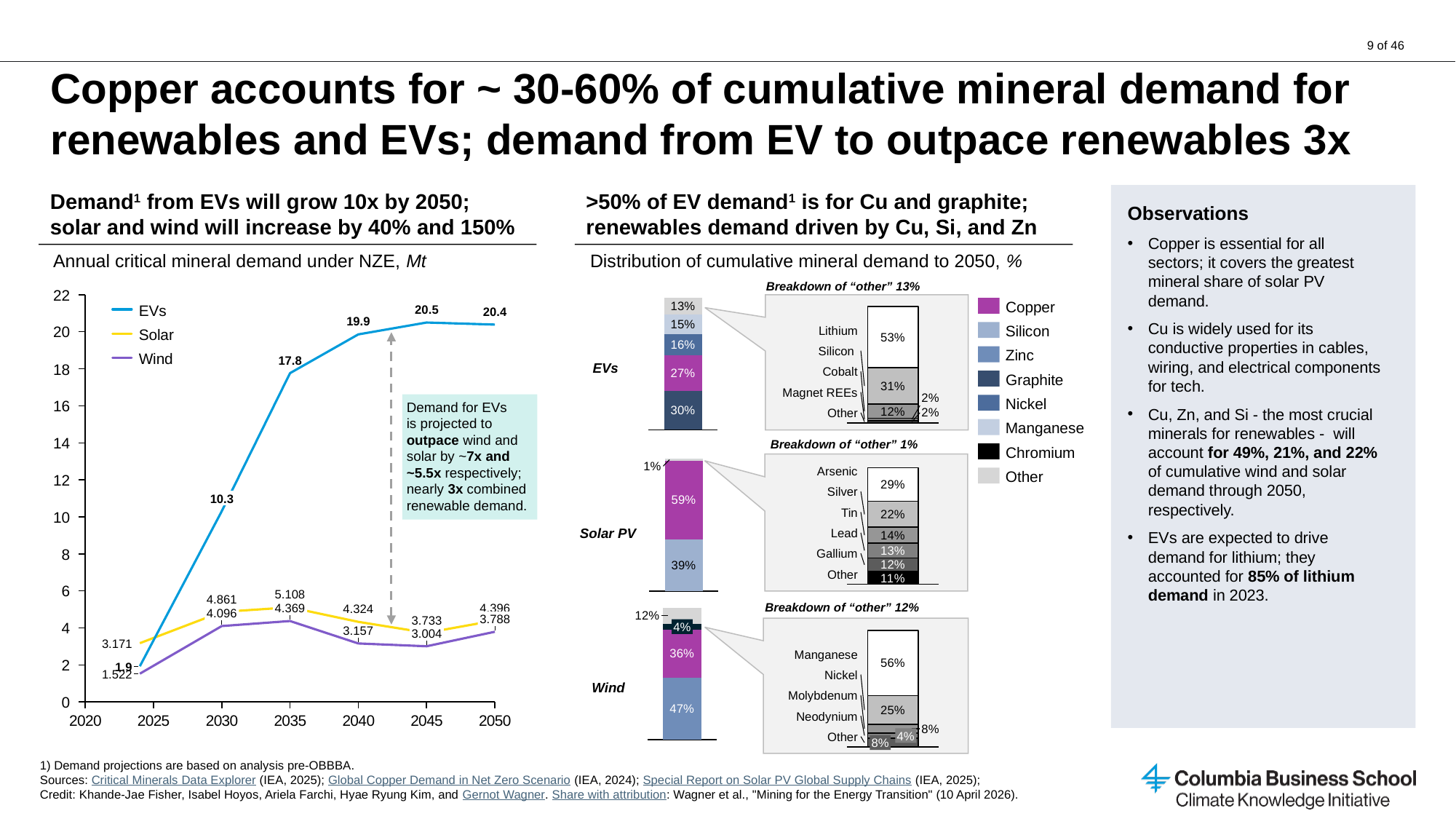
In the left chart, 'Annual critical mineral demand under NZE, Mt', which series has the highest value in 2050? EVs In the right chart, 'Distribution of cumulative mineral demand to 2050, %', what share of Solar PV demand is Copper? 59% In the right chart's 'Breakdown of "other" 13%' for EVs, what share is Lithium? 53% How many series does the legend of the left chart, 'Annual critical mineral demand under NZE, Mt', list? 3 In the left chart, 'Annual critical mineral demand under NZE, Mt', does the EVs line rise or fall between 2030 and 2045? Rises What kind of chart is the left chart, 'Annual critical mineral demand under NZE, Mt'? Line chart In the left chart, 'Annual critical mineral demand under NZE, Mt', what is the Solar value in 2035? 5.108 In the left chart, 'Annual critical mineral demand under NZE, Mt', what is the difference between the Solar and Wind values in 2030? 0.765 In the left chart, 'Annual critical mineral demand under NZE, Mt', what is the EVs value in 2030? 10.3 In the left chart, 'Annual critical mineral demand under NZE, Mt', what is the Wind value in 2045? 3.004 In the left chart, 'Annual critical mineral demand under NZE, Mt', what is the EVs value in 2050? 20.4 In the right chart, 'Distribution of cumulative mineral demand to 2050, %', is the Copper share larger for Solar PV or for Wind? Solar PV